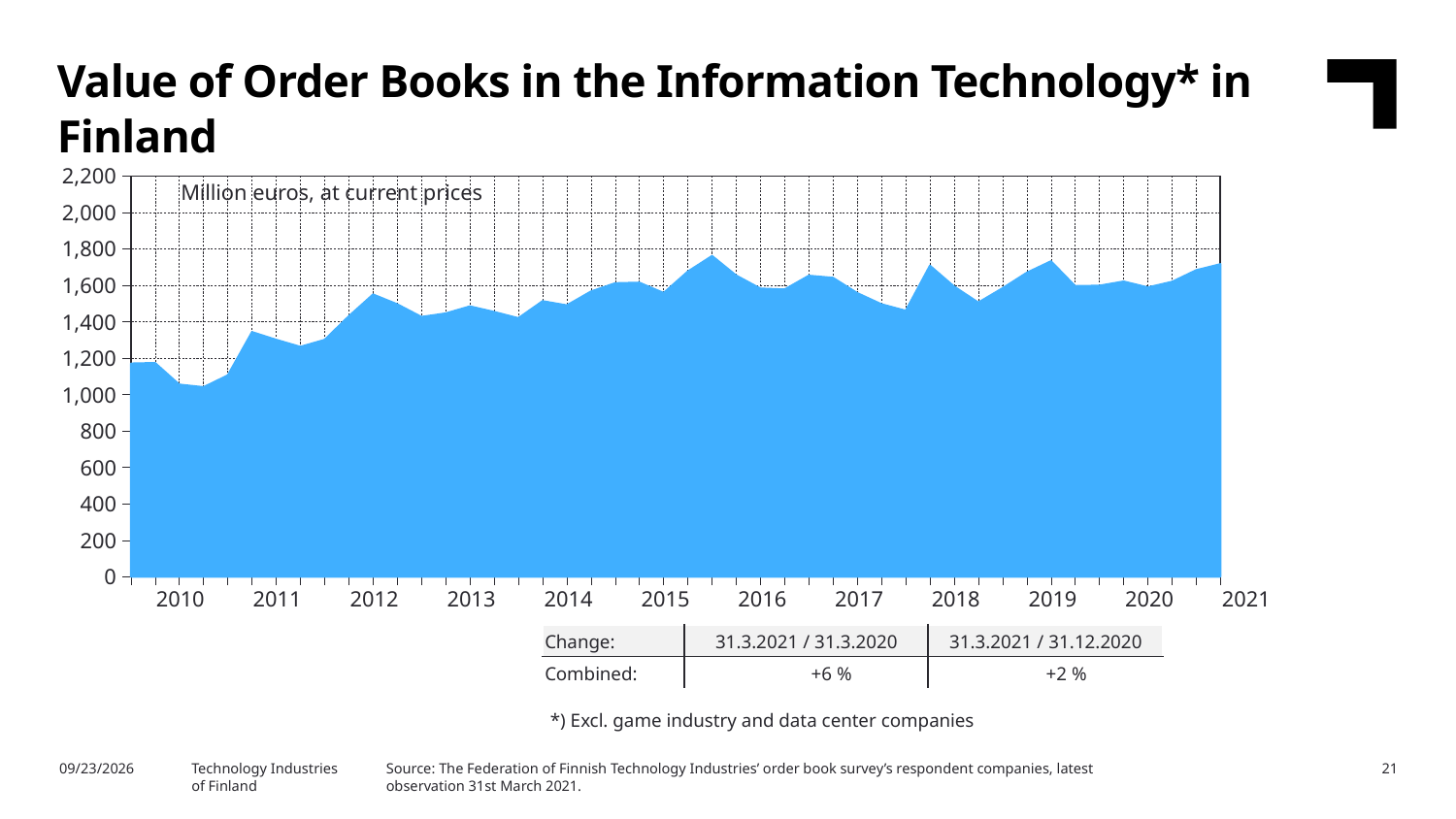
How many years are labeled on the x axis of the chart? 12 Is the peak value in 2012 greater or less than 1,400? greater Is the lowest value during 2017 greater or less than 1,200? greater What is the highest value shown on the y axis of the chart? 2,200 Is the value at the start of 2010 greater or less than 1,400? less Overall, do the order book values rise or fall from 2010 to 2021? rise What kind of chart is shown on the slide? Area chart What unit is stated inside the chart area? Million euros, at current prices What is the title of the chart on the slide? Value of Order Books in the Information Technology* in Finland